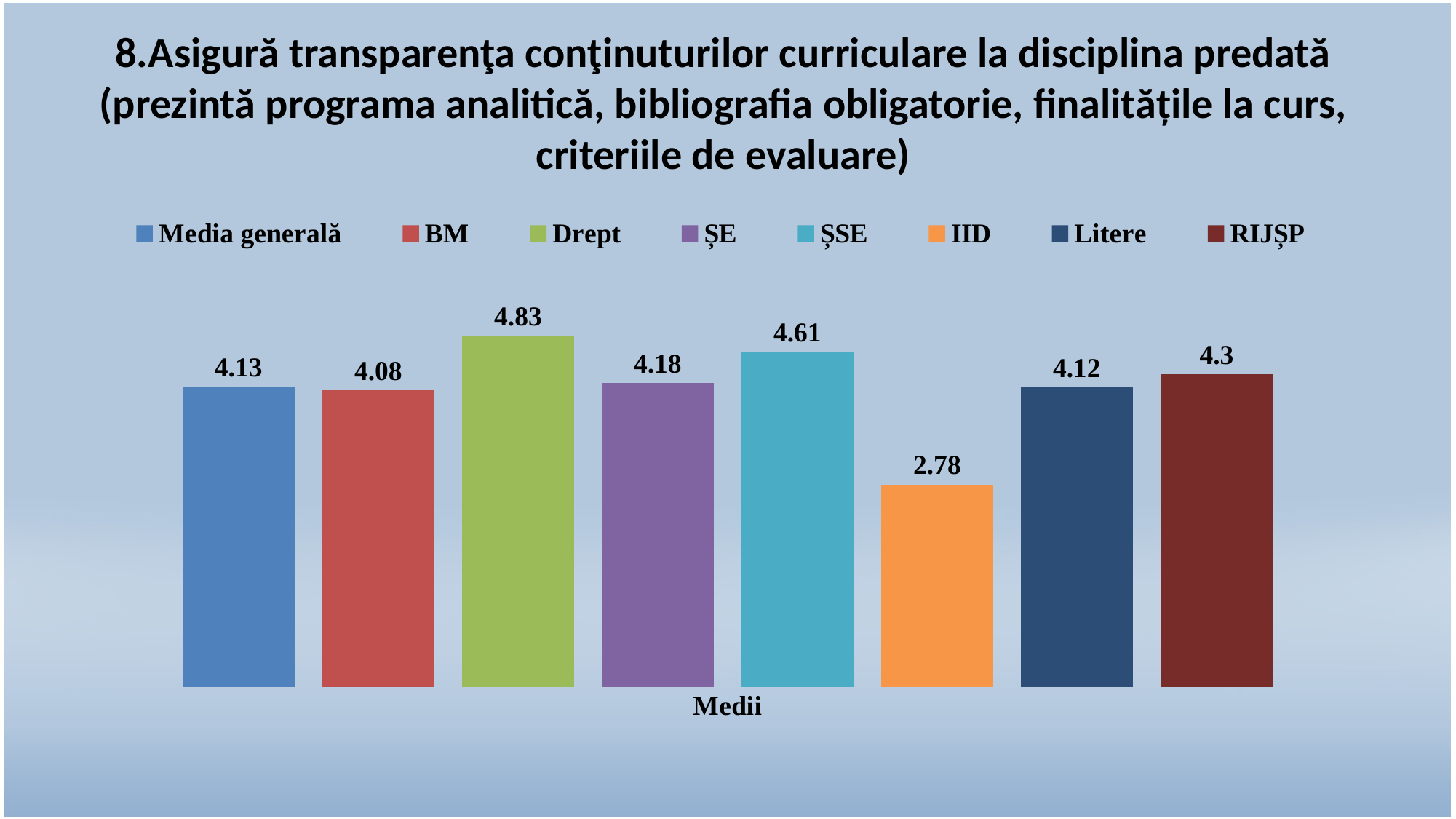
What is the label shown on the x axis below the bars? Medii What is the value for IID? 2.78 Which series has the highest value? Drept What is the value for Media generală? 4.13 Which series has the lowest value? IID What is the difference between the values for Drept and IID? 2.05 What kind of chart is shown on the slide? Bar chart Which is larger, the value for ȘSE or the value for Litere? ȘSE How many series does the legend list? 8 What is the value for RIJȘP? 4.3 What is the difference between the values for ȘSE and BM? 0.53 What is the value for Drept? 4.83